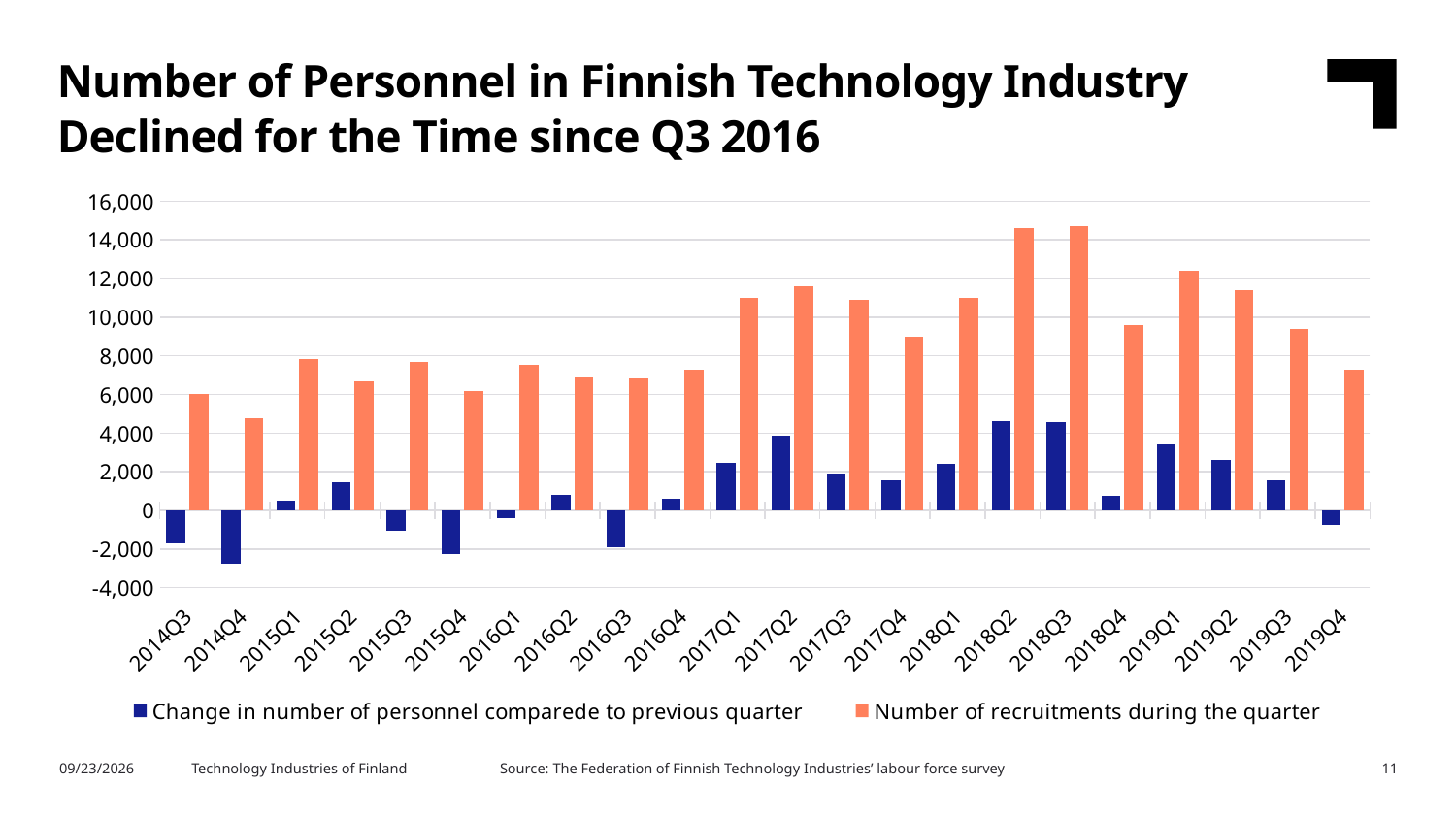
Is the number of recruitments during the quarter for 2018Q3 greater or less than 14,000? greater Which quarter has the lowest number of recruitments during the quarter? 2014Q4 Which quarter has the larger number of recruitments during the quarter, 2019Q1 or 2019Q2? 2019Q1 How many quarters are shown on the x axis? 22 Is the change in number of personnel for 2017Q2 greater or less than 2,000? greater Which quarter has the lowest change in number of personnel compared to previous quarter? 2014Q4 What kind of chart is shown on the slide? bar chart Do the number of recruitments during the quarter rise or fall from 2018Q3 to 2019Q4? fall How many series does the legend list? 2 Is the change in number of personnel for 2019Q4 greater or less than 0? less What colour are the bars for the number of recruitments during the quarter? orange